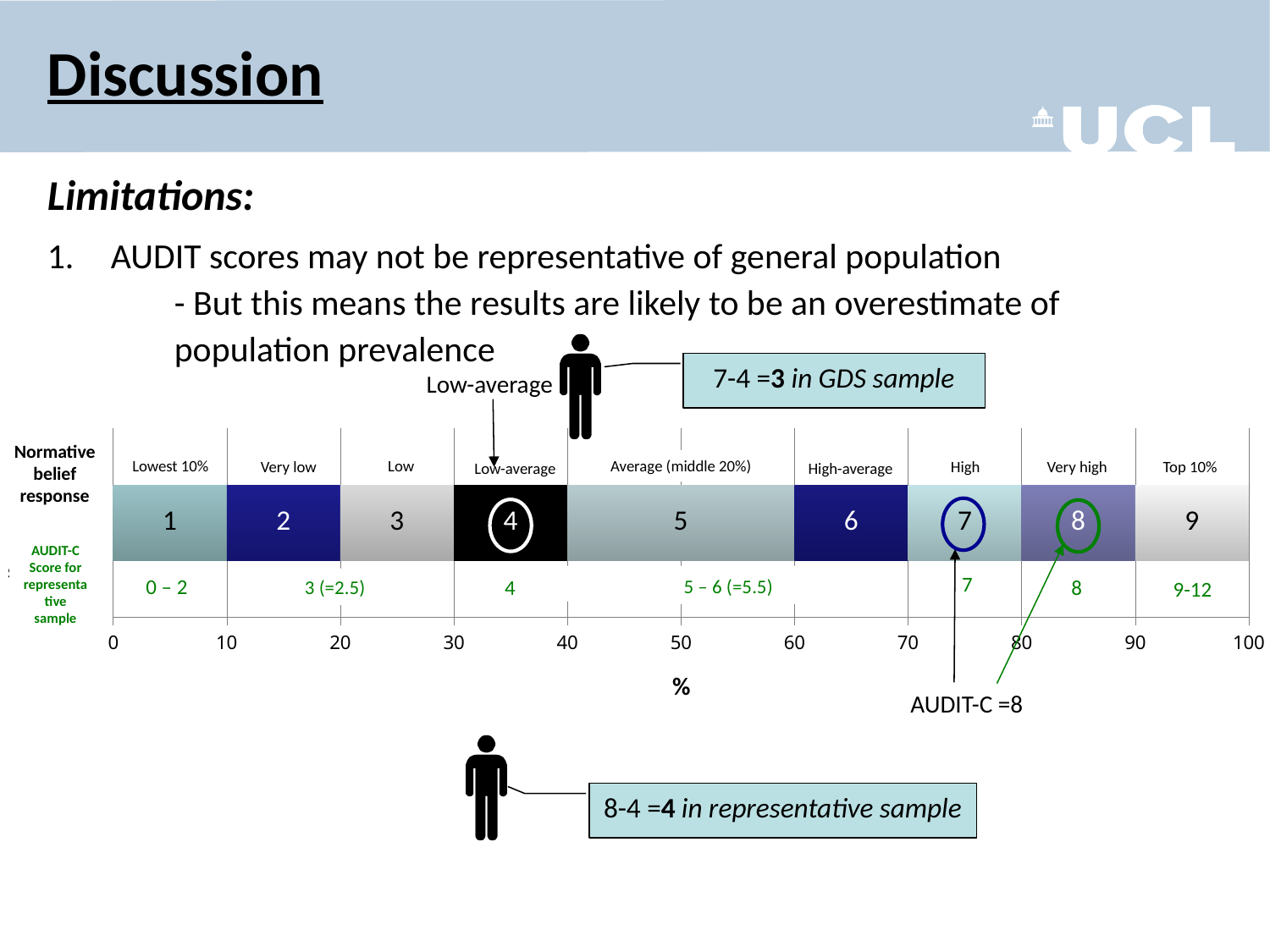
Which normative belief response category is the widest segment of the bar? Average (middle 20%) What AUDIT-C score for the representative sample corresponds to the 'Very low' segment? 3 (=2.5) What kind of chart is shown on the slide? bar chart What is the width in percentage points of the 'Average (middle 20%)' segment, based on the axis ticks it spans? 20 Which segment number is labelled 'Very high'? 8 What AUDIT-C score for the representative sample corresponds to the 'Top 10%' segment? 9-12 What is the label on the horizontal axis of the chart? % Between which two percentage ticks does the 'Average (middle 20%)' segment span? 40 to 60 How many normative belief response segments (numbered categories) does the bar contain? 9 What AUDIT-C score for the representative sample corresponds to the 'Average (middle 20%)' segment? 5 – 6 (=5.5) What is the normative belief label for segment number 4? Low-average What is the maximum value shown on the percentage axis? 100